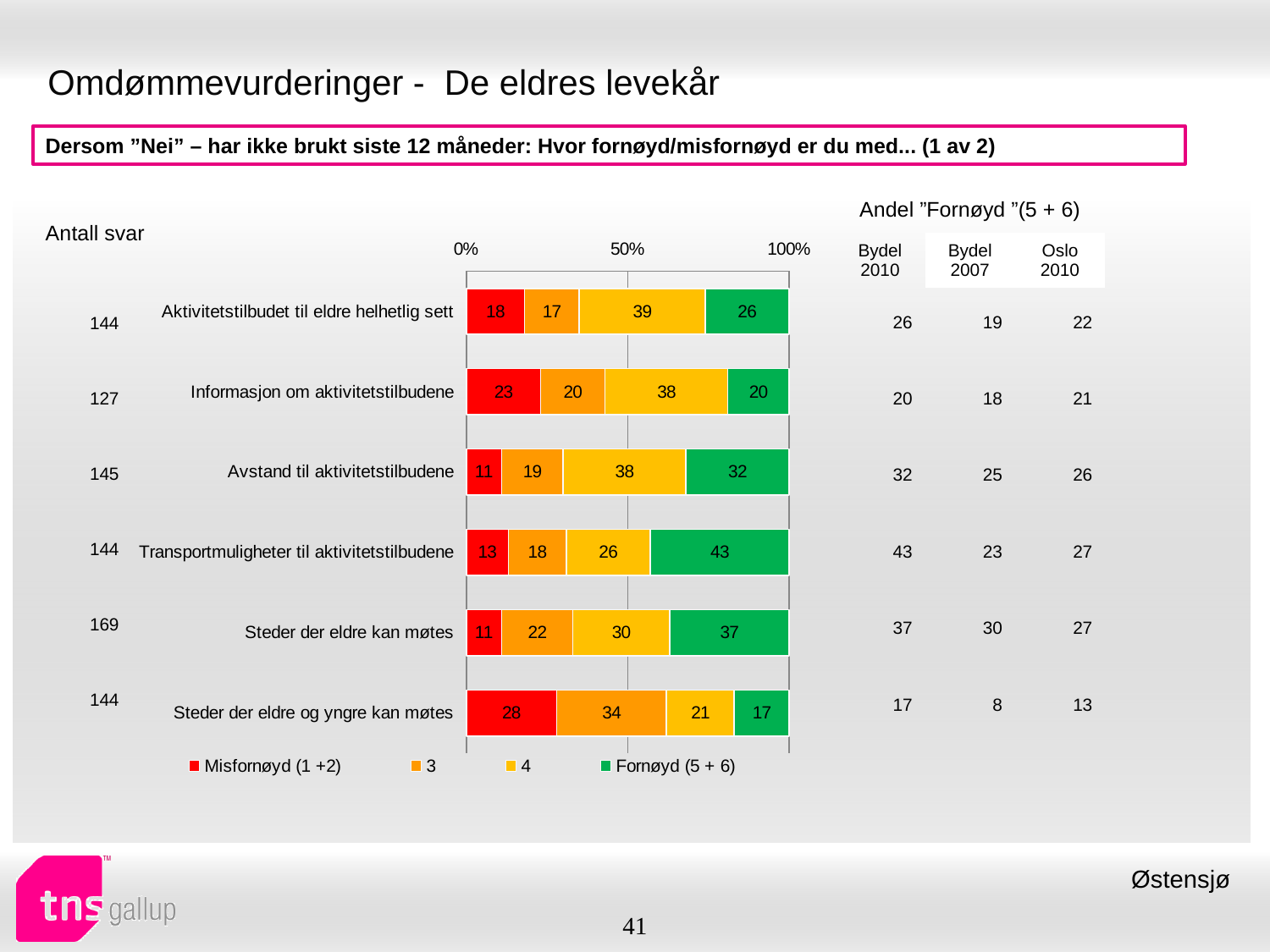
What kind of chart is shown on the slide? Stacked bar chart What is the value of the "Misfornøyd (1 +2)" segment for "Steder der eldre og yngre kan møtes"? 28 What colour represents the "Fornøyd (5 + 6)" series in the chart? Green What is the value of the "4" segment for "Aktivitetstilbudet til eldre helhetlig sett"? 39 What is the value of the "Fornøyd (5 + 6)" segment for "Transportmuligheter til aktivitetstilbudene"? 43 How many categories are shown in the chart? 6 Which is larger: the "Misfornøyd (1 +2)" value for "Informasjon om aktivitetstilbudene" or for "Avstand til aktivitetstilbudene"? Informasjon om aktivitetstilbudene How many series does the legend list? 4 What is the total of the stacked bar for "Steder der eldre kan møtes"? 100 Which category has the highest "Fornøyd (5 + 6)" value? Transportmuligheter til aktivitetstilbudene Which category has the lowest "Fornøyd (5 + 6)" value? Steder der eldre og yngre kan møtes What is the difference between the "Fornøyd (5 + 6)" values for "Transportmuligheter til aktivitetstilbudene" and "Steder der eldre og yngre kan møtes"? 26